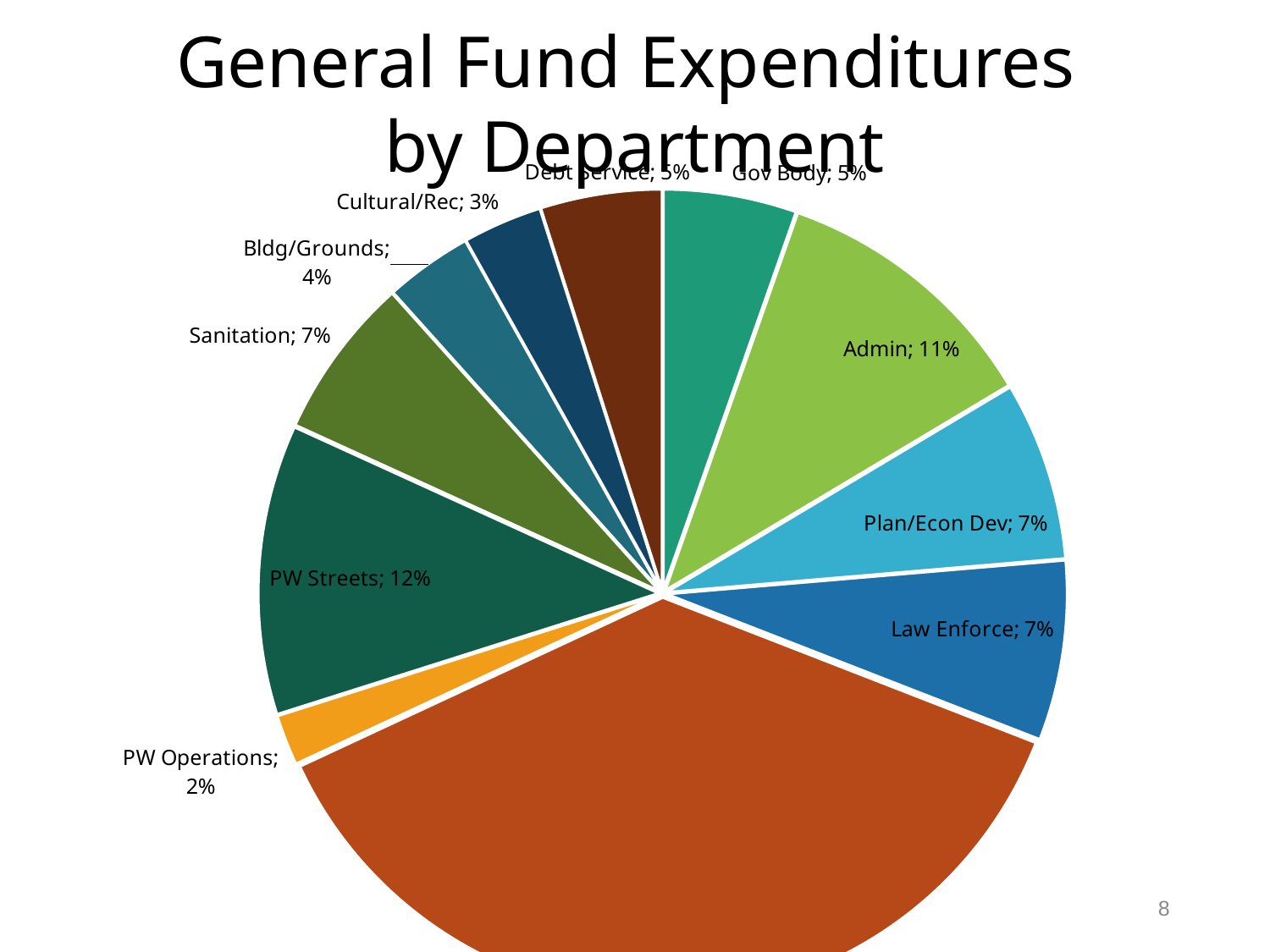
What percentage is shown for PW Streets? 12% What share is labelled for Cultural/Rec? 3% What percentage is shown for Bldg/Grounds? 4% How many percentage points larger is the PW Streets share than the Admin share? 1 percentage point How many slices does the pie chart contain? 11 What percentage is shown for Debt Service? 5% What share of General Fund Expenditures goes to Admin? 11% What percentage is shown for Sanitation? 7% What is the title of the chart? General Fund Expenditures by Department Which labelled department has the smallest share of expenditures? PW Operations What type of chart is shown on the slide? Pie chart Which is larger, the share for Admin or the share for Sanitation? Admin